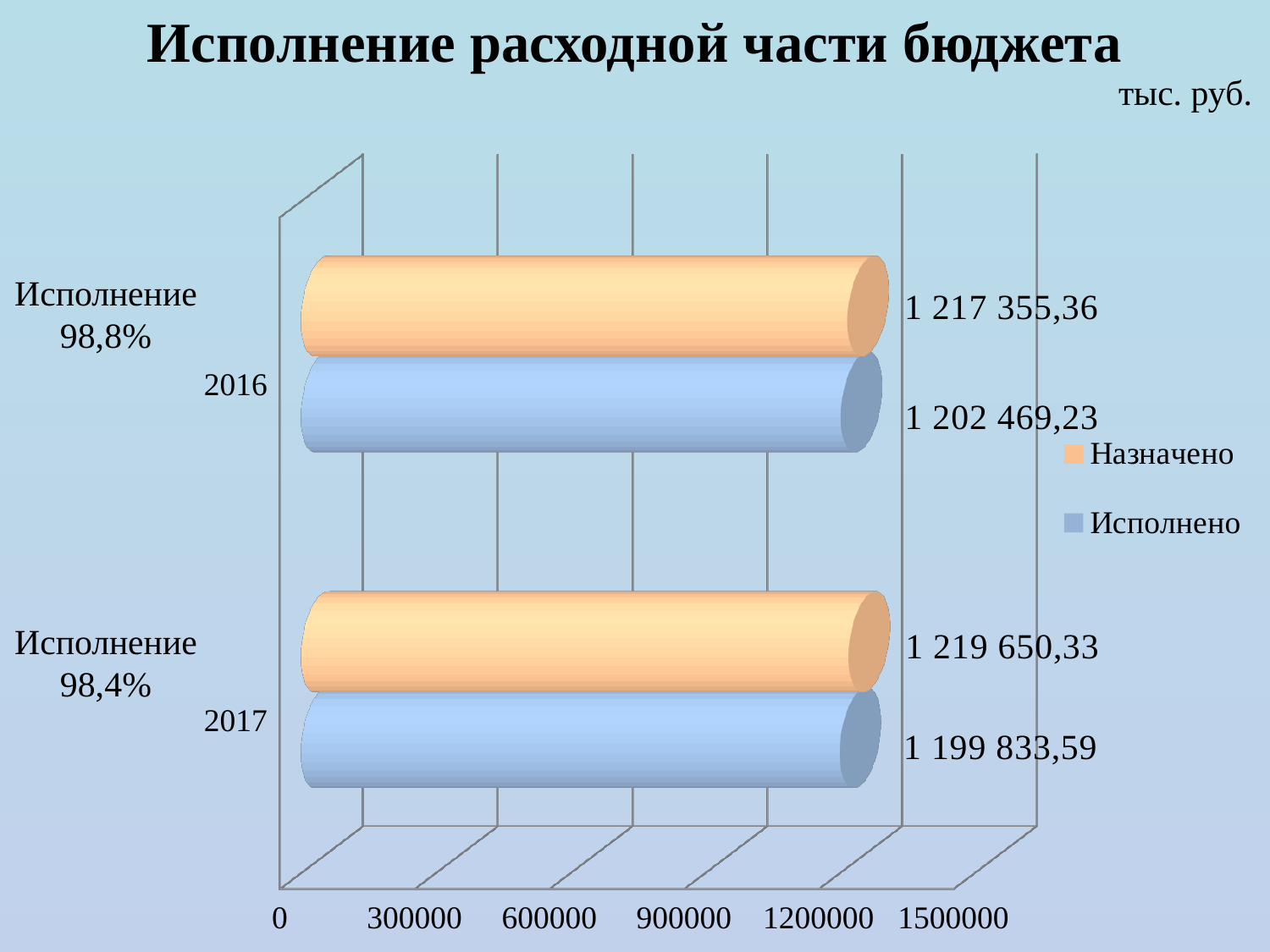
How many series does the legend list? 2 Which year has the higher Назначено value? 2017 How many years (categories) are shown on the chart? 2 What type of chart is shown on the slide? bar chart What is the value of Назначено for 2016? 1 217 355,36 What is the value of Назначено for 2017? 1 219 650,33 Is the Исполнено value for 2016 greater or less than 900000? greater What is the difference between Назначено and Исполнено for 2016? 14 886,13 What is the value of Исполнено for 2017? 1 199 833,59 What is the difference between Назначено and Исполнено for 2017? 19 816,74 What is the title of the chart? Исполнение расходной части бюджета Which year has the lower Исполнено value? 2017